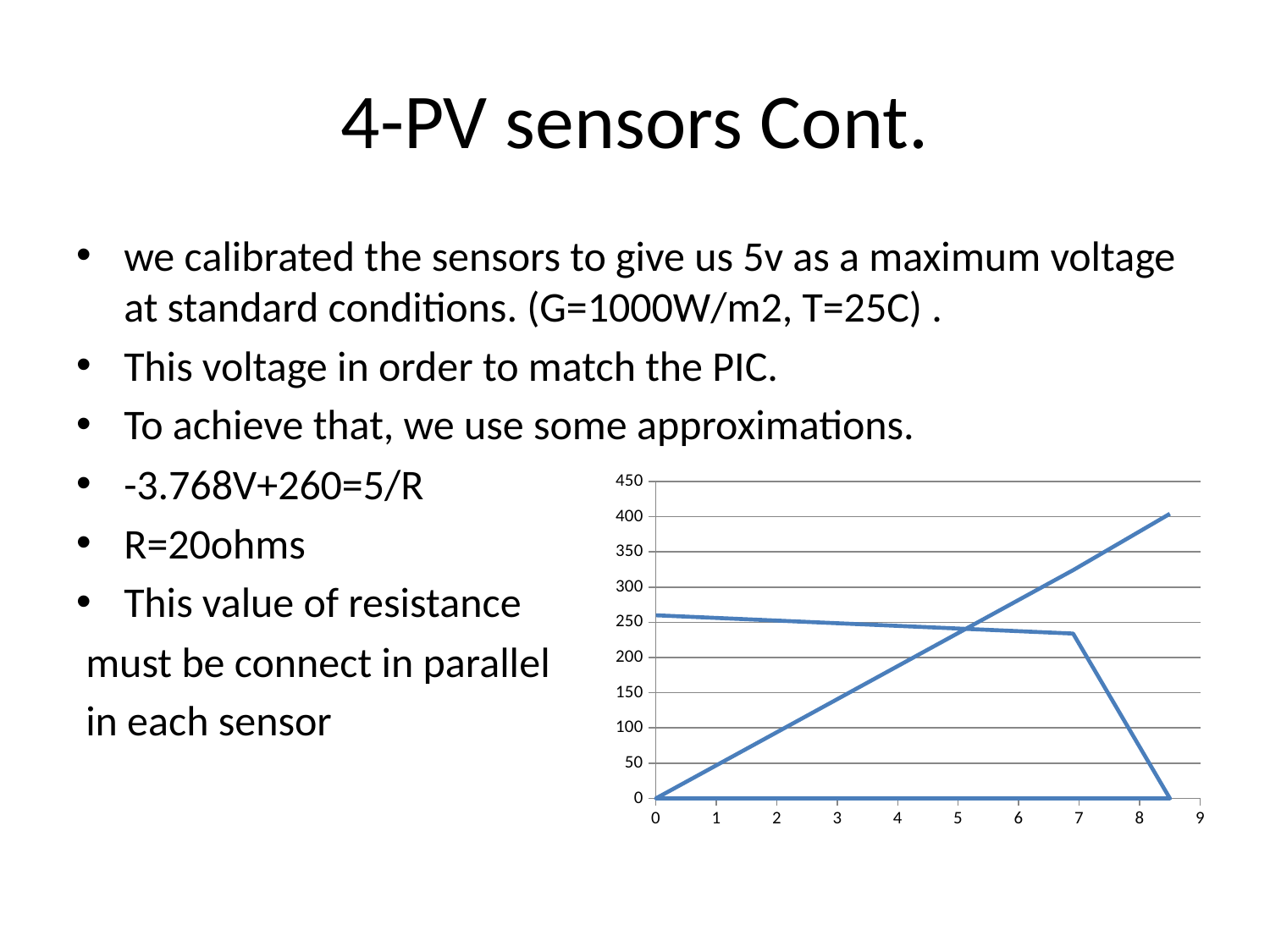
What kind of chart is shown on the slide? line chart Is the value of the upper, gently sloping line at x = 7 greater or less than 200? greater What is the highest value shown on the vertical axis of the chart? 450 Is the value of the rising line at x = 8 greater or less than 300? greater Is the value of the upper, gently sloping line at x = 3 greater or less than 300? less What is the spacing between consecutive tick labels on the vertical axis of the chart? 50 Does the upper, gently sloping line rise or fall as x goes from 0 to 7? fall Does the rising line in the chart increase or decrease as x goes from 0 to 8? increase What is the highest value shown on the horizontal axis of the chart? 9